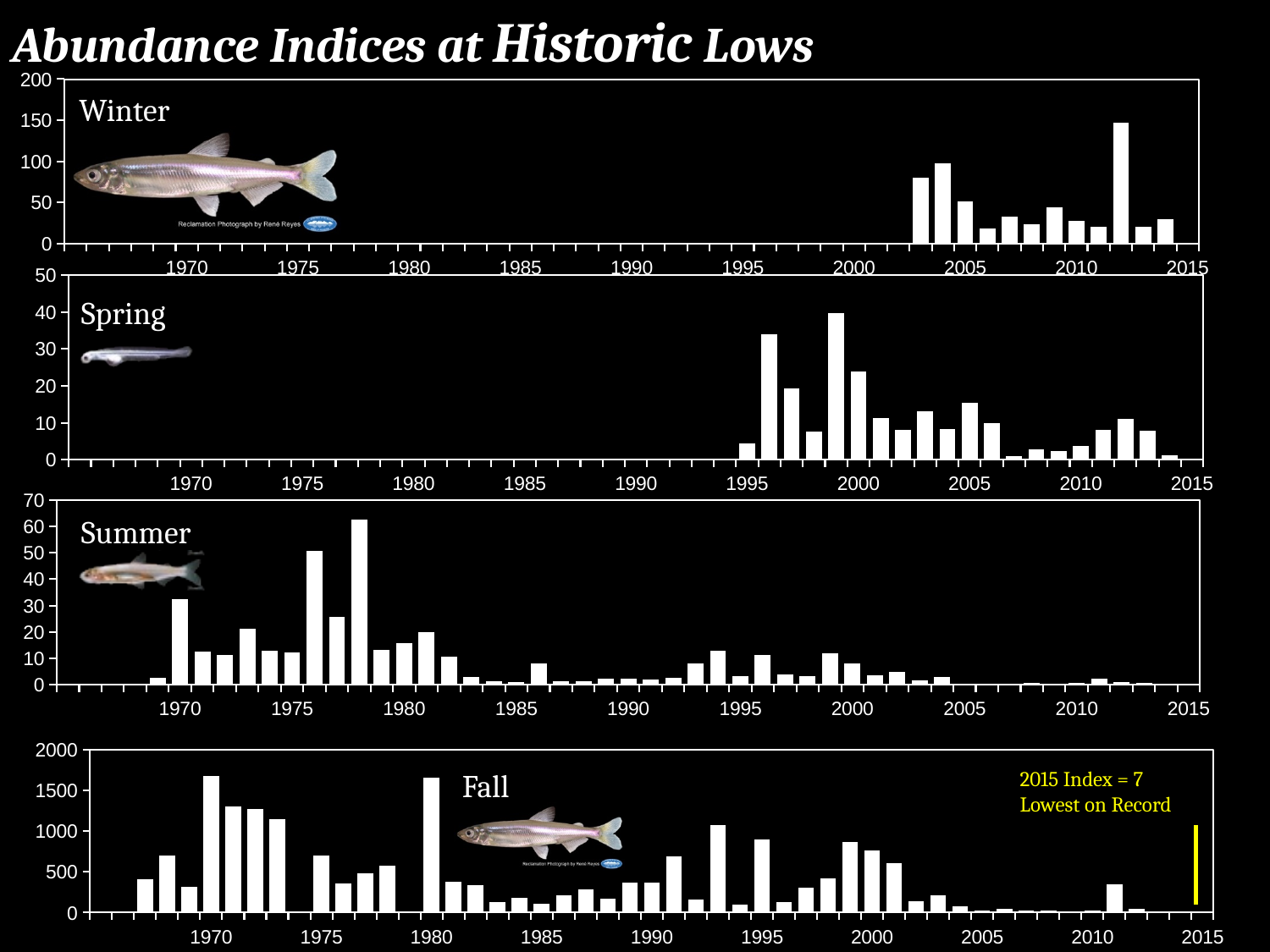
What kind of chart is used for the Winter panel? bar chart What is the title of the slide? Abundance Indices at Historic Lows In the Fall chart, is the value for 1970 greater or less than 1500? greater How many seasonal charts are shown on the slide? 4 In the Spring chart, which is larger, the value for 1996 or the value for 1999? 1999 In the Spring chart, is the value for 1999 greater or less than 30? greater In the Summer chart, is the value for 1978 greater or less than 50? greater In the Spring chart, which year has the highest bar? 1999 In the Winter chart, which year has the highest bar? 2012 In the Fall chart, what is the 2015 index value? 7 In the Summer chart, which year has the highest bar? 1978